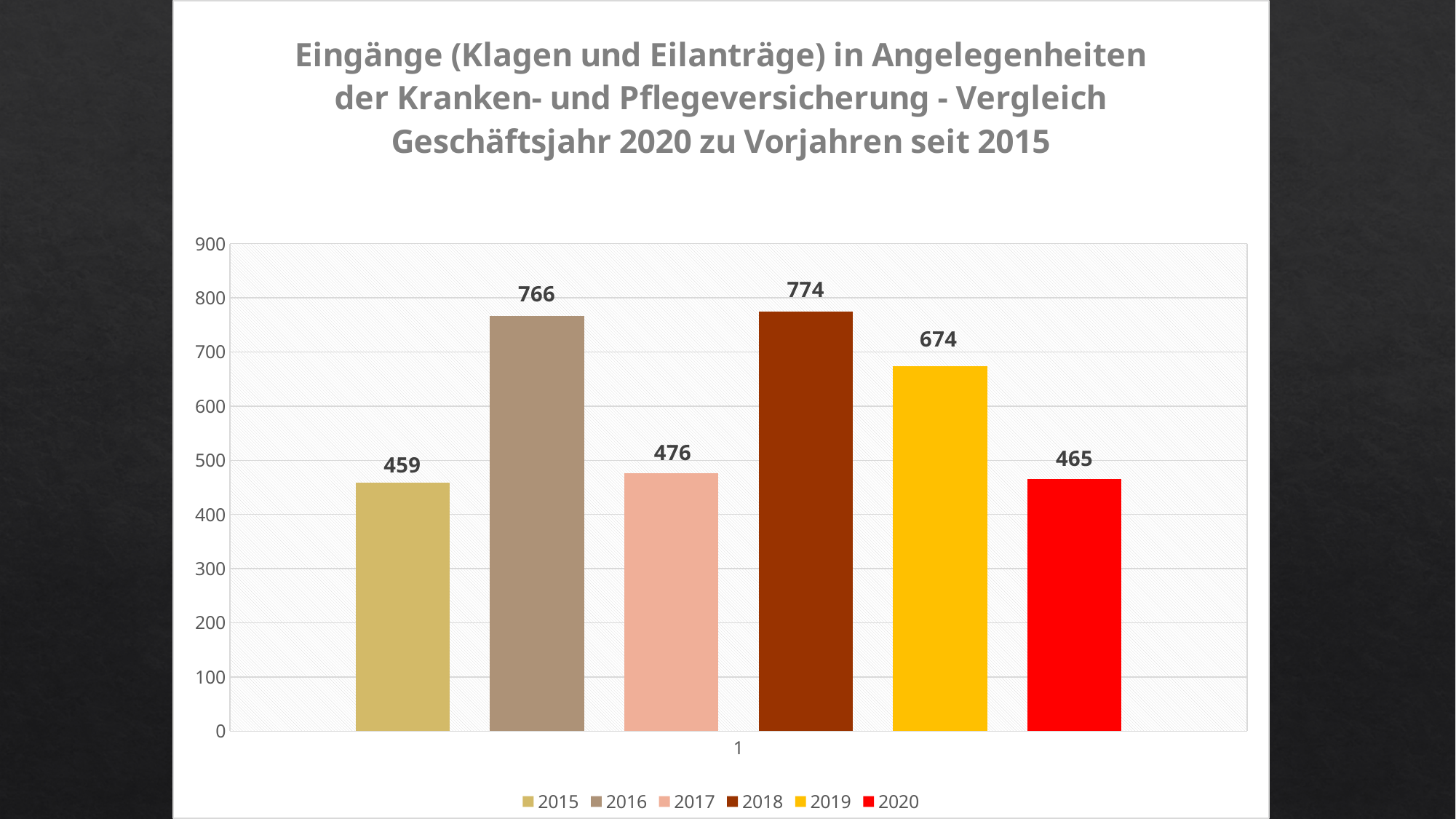
Which colour is used for the 2020 bar? red Which year has the lowest value? 2015 What is the value for 2015? 459 How many series does the legend list? 6 Is the value for 2019 greater or less than 600? greater Which is larger, the value for 2016 or the value for 2019? 2016 What is the difference between the values for 2019 and 2020? 209 What is the value for 2020? 465 What kind of chart is shown on the slide? bar chart What is the value for 2018? 774 Which year has the highest value? 2018 What is the difference between the values for 2016 and 2017? 290